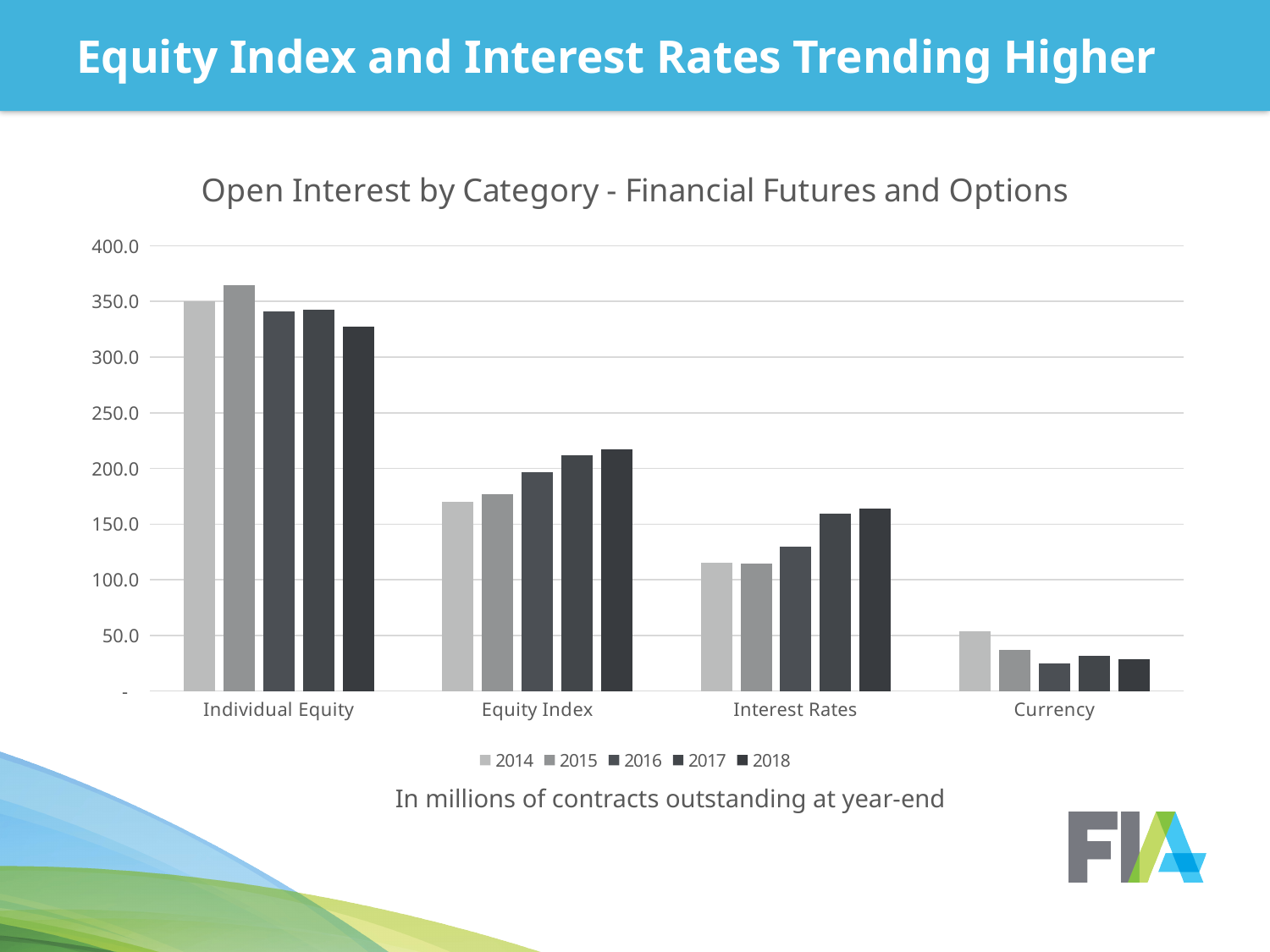
Is the value for Equity Index in 2018 greater or less than 200? greater Is the value for Currency in 2016 greater or less than 50? less How many categories are shown on the x axis of the chart? 4 Which category has the highest open interest in the chart? Individual Equity What is the title of the chart? Open Interest by Category - Financial Futures and Options Do the Equity Index bars rise or fall from 2014 to 2018? rise What kind of chart is shown on the slide? Bar chart Is the value for Individual Equity in 2014 greater or less than 300? greater How many series does the legend list? 5 Which category has the lowest open interest in the chart? Currency Which is larger in 2018, Equity Index or Interest Rates? Equity Index